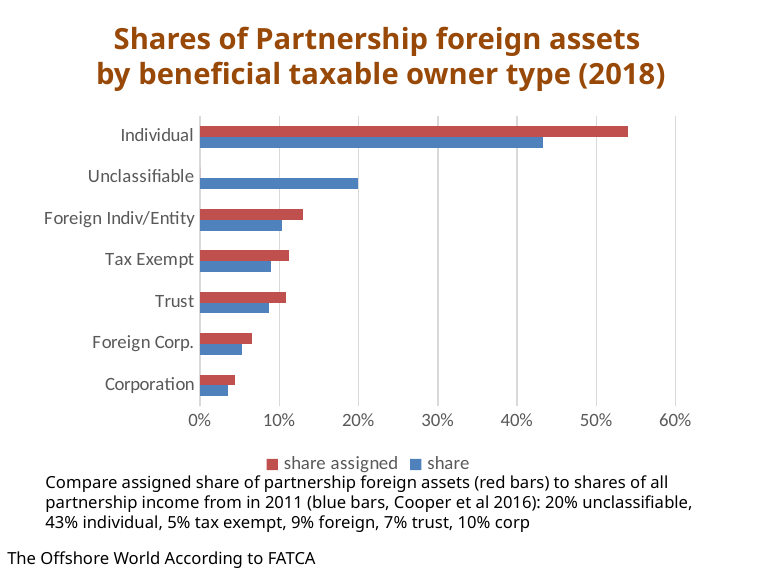
Is the 'share' value for Individual greater or less than 50%? less How many series does the legend list? 2 What kind of chart is shown on the slide? bar chart How many owner-type categories are plotted on the chart? 7 Is the 'share' value for Unclassifiable greater or less than 10%? greater Is the 'share assigned' value for Individual greater or less than 50%? greater For Individual, which is larger: 'share assigned' or 'share'? share assigned Which colour represents the 'share assigned' series? red What is the title of the chart? Shares of Partnership foreign assets by beneficial taxable owner type (2018) Which category has the highest 'share assigned' value? Individual